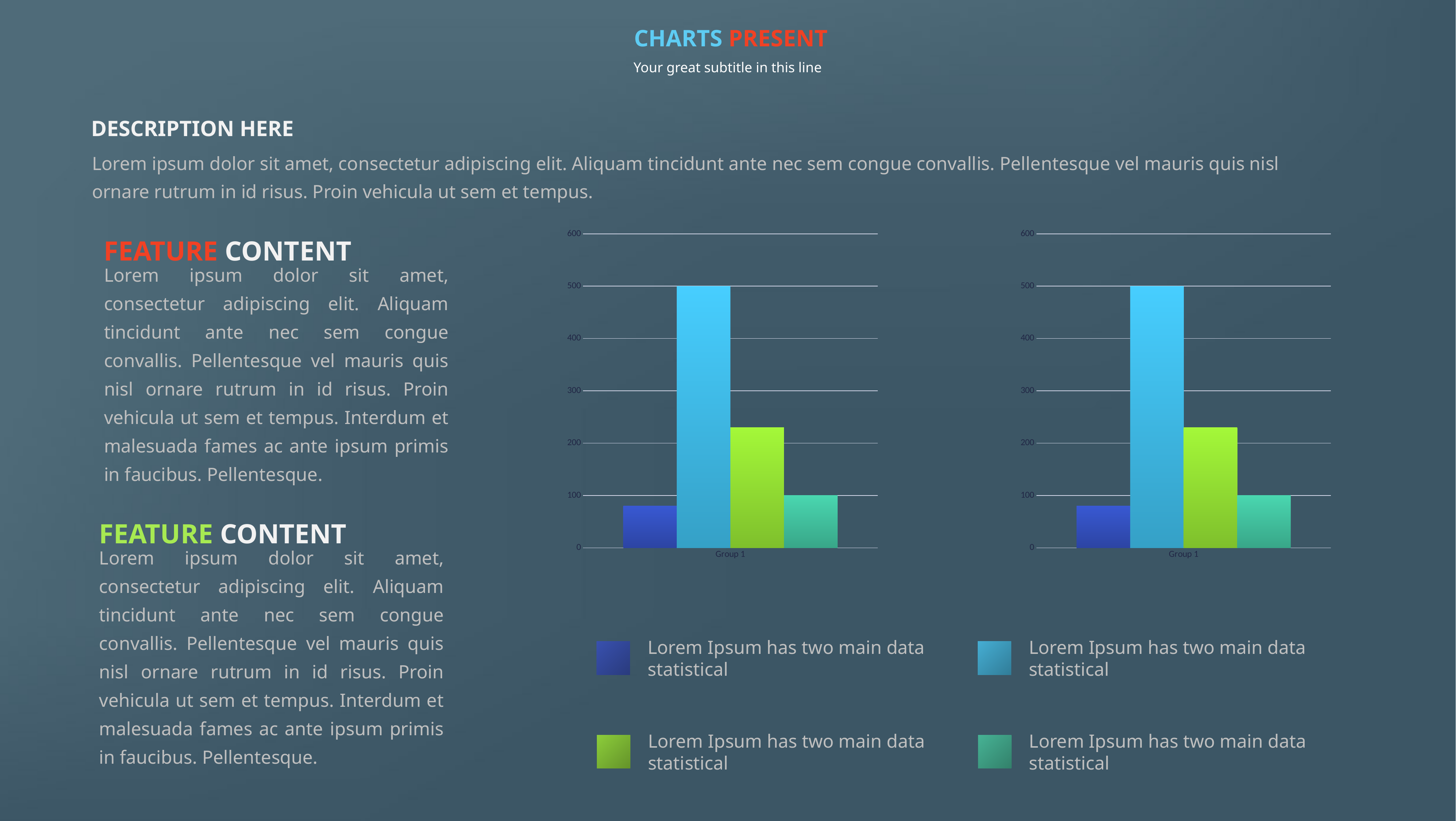
In the right chart, what value does the teal bar reach for Group 1? 100 In the left chart, what value does the light blue bar reach for Group 1? 500 How many series does the legend below the charts list? 4 In the right chart, is the value of the green bar for Group 1 greater or less than 300? less In the right chart, which bar is the shortest for Group 1? the dark blue bar In the right chart, which is larger for Group 1, the green bar or the teal bar? the green bar In the left chart, is the value of the dark blue bar for Group 1 greater or less than 100? less In the right chart, what is the label of the category on the x axis? Group 1 In the left chart, is the value of the green bar for Group 1 greater or less than 200? greater In the left chart, which bar is the tallest for Group 1? the light blue bar What kind of chart is the left chart on the slide? bar chart In the left chart, how many categories are shown on the x axis? 1